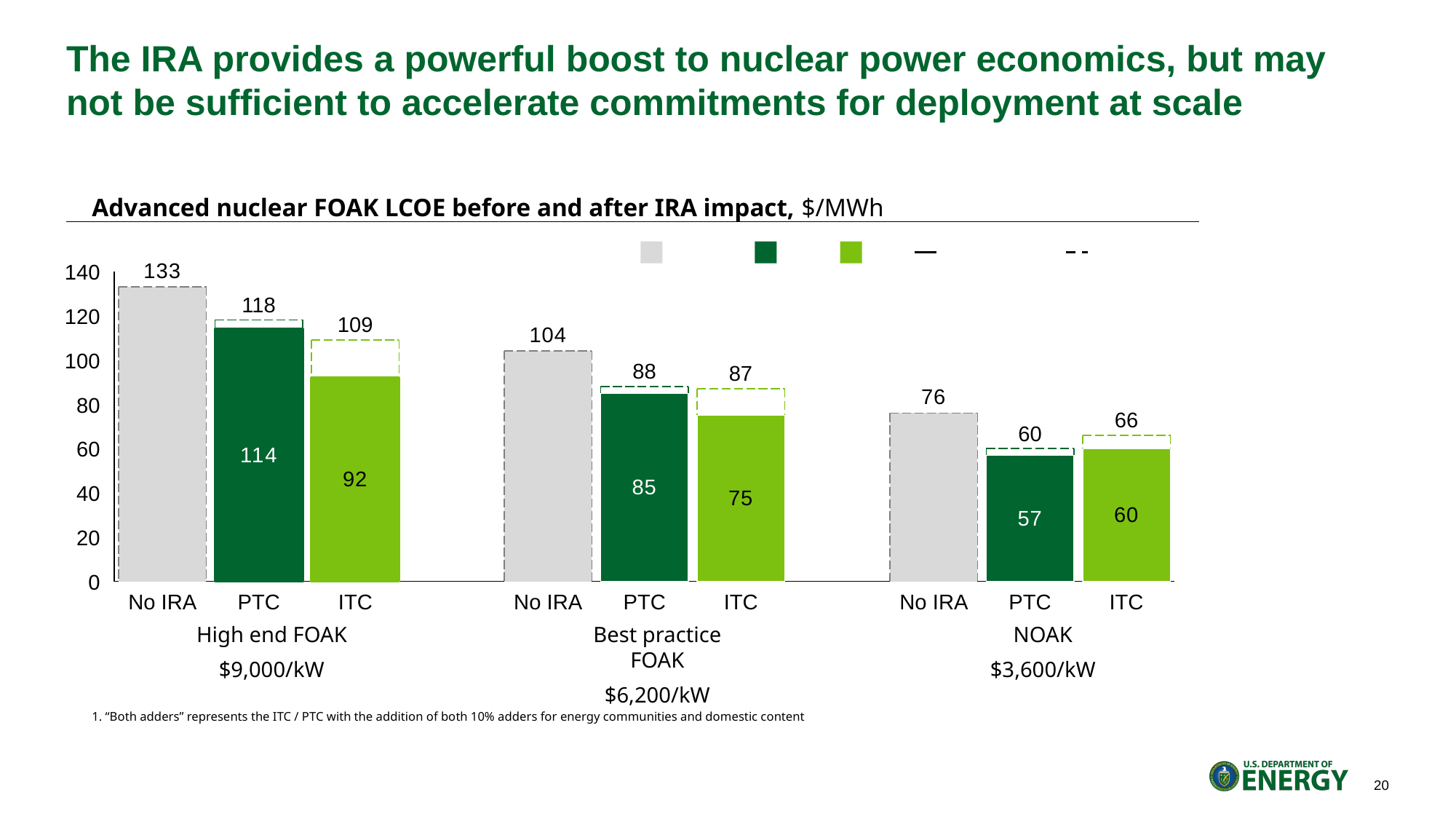
Which bar has the highest value on the chart? No IRA, High end FOAK What is the No IRA value for the NOAK group? 76 What value is printed above the dashed outline for ITC in the High end FOAK group? 109 What is the LCOE value for No IRA in the High end FOAK group? 133 What value is printed inside the solid PTC bar in the High end FOAK group? 114 What value is printed inside the solid ITC bar in the Best practice FOAK group? 75 What unit is the chart's LCOE measured in, according to the chart title? $/MWh Which solid bar has the lowest value on the chart? PTC, NOAK What kind of chart is shown on the slide? Bar chart In the NOAK group, which solid bar is larger, PTC or ITC? ITC What is the difference between the No IRA value and the solid PTC bar value in the High end FOAK group? 19 How many bars are plotted on the chart in total? 9